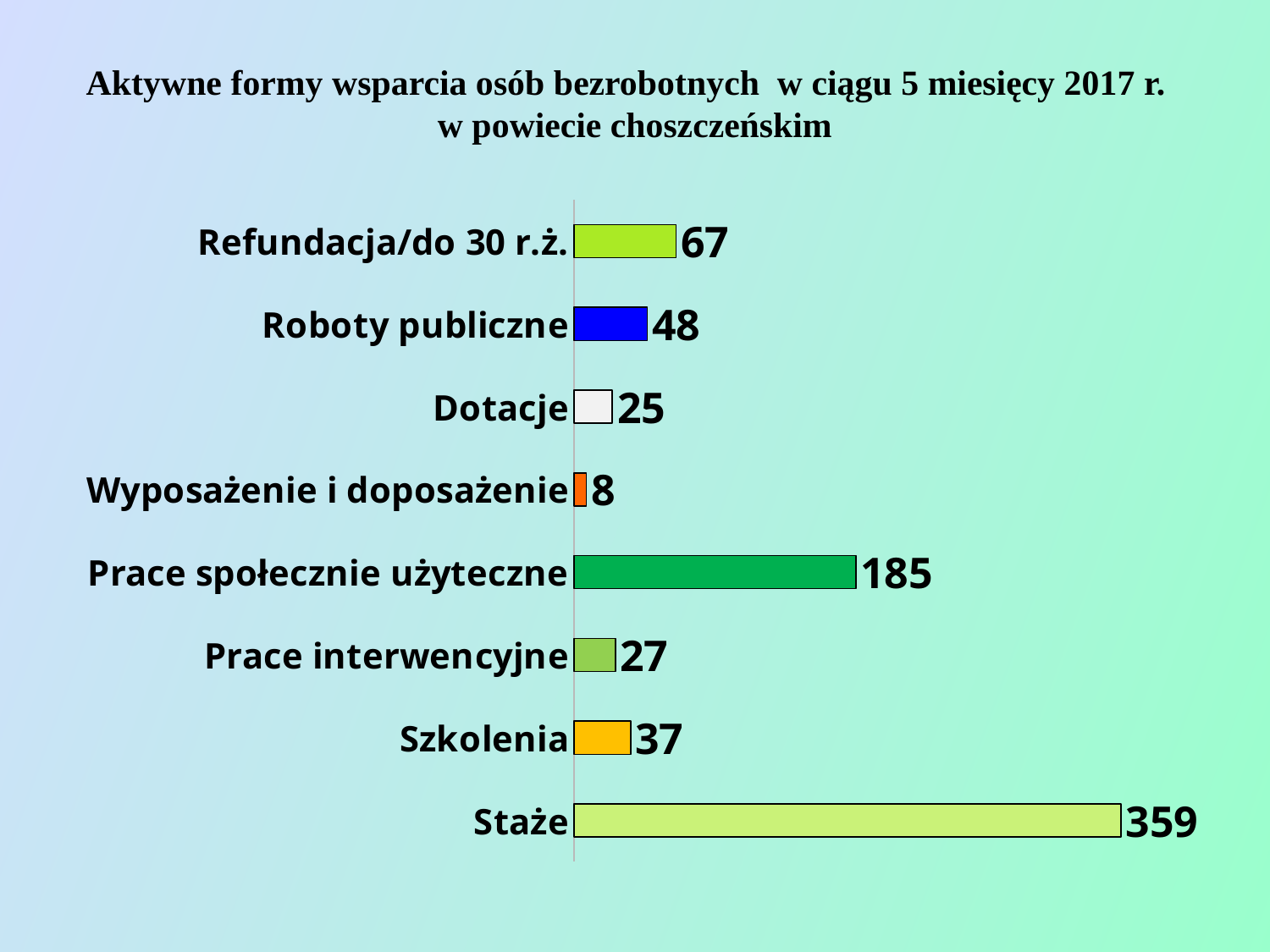
What is the value for Roboty publiczne? 48 What is the value for Prace społecznie użyteczne? 185 What is the difference between the values for Staże and Prace społecznie użyteczne? 174 What is the difference between the values for Refundacja/do 30 r.ż. and Roboty publiczne? 19 How many categories are shown in the chart? 8 Which category has the lowest value? Wyposażenie i doposażenie What kind of chart is shown on the slide? Bar chart What colour is the bar for Roboty publiczne? Blue What is the value for Staże? 359 What is the value for Wyposażenie i doposażenie? 8 Which category has the highest value? Staże Which is larger, the value for Szkolenia or the value for Prace interwencyjne? Szkolenia